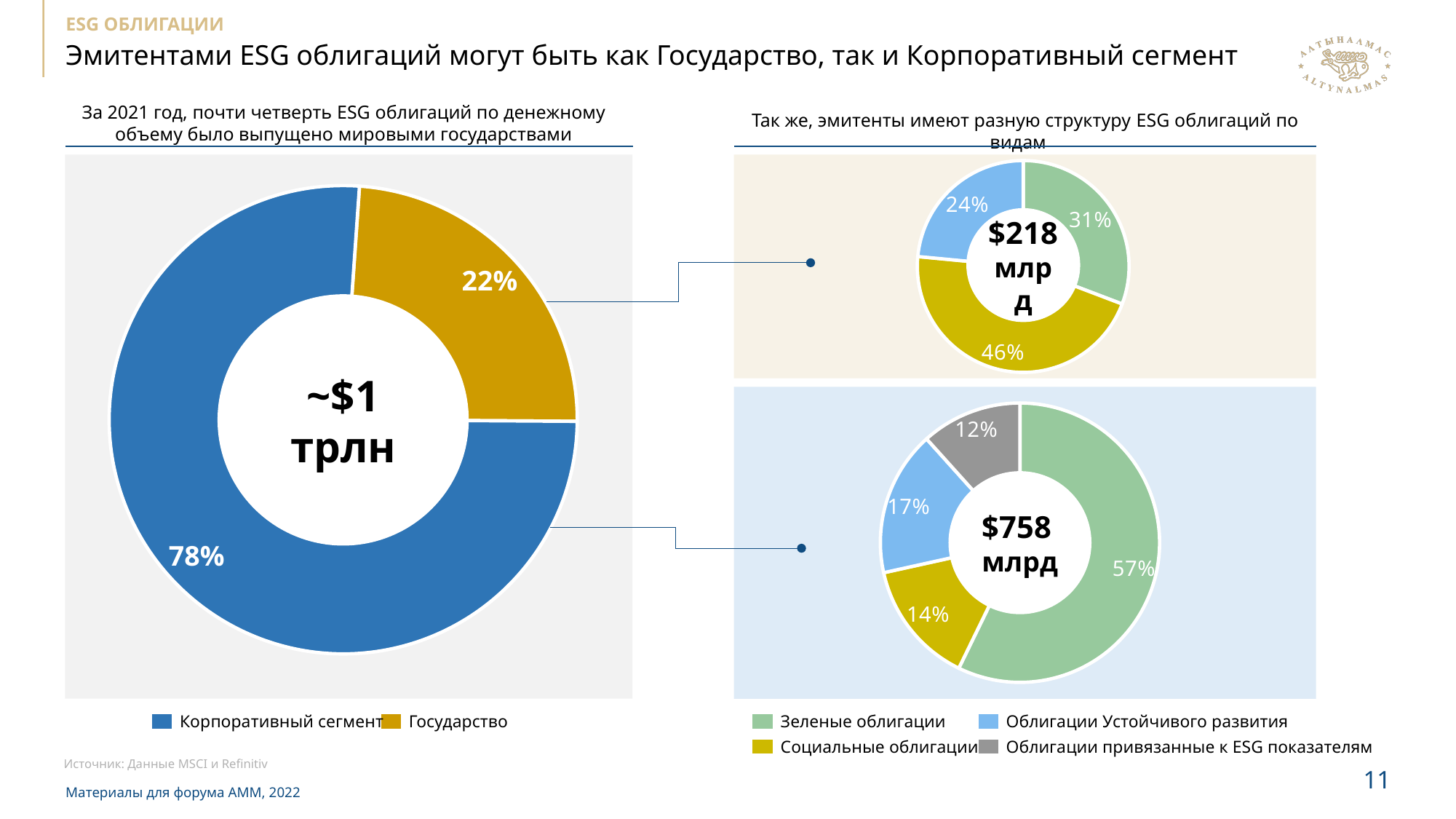
In the bottom-right donut chart ($758 млрд), how many segments are shown? 4 In the large donut chart on the left, what share is labelled for Корпоративный сегмент? 78% In the large donut chart on the left, which segment is larger: Корпоративный сегмент or Государство? Корпоративный сегмент In the top-right donut chart ($218 млрд), what share is labelled for Зеленые облигации? 31% In the top-right donut chart ($218 млрд), which bond type has the smallest share? Облигации Устойчивого развития In the large donut chart on the left, what share is labelled for Государство? 22% In the bottom-right donut chart ($758 млрд), what share is labelled for Зеленые облигации? 57% In the bottom-right donut chart ($758 млрд), what share is labelled for Облигации привязанные к ESG показателям? 12% How many entries does the legend below the two right-hand donut charts list? 4 In the top-right donut chart ($218 млрд), what share is labelled for Социальные облигации? 46% In the large donut chart on the left, what is the difference in percentage points between Корпоративный сегмент and Государство? 56 In the large donut chart on the left, what total value is printed in the centre? ~$1 трлн